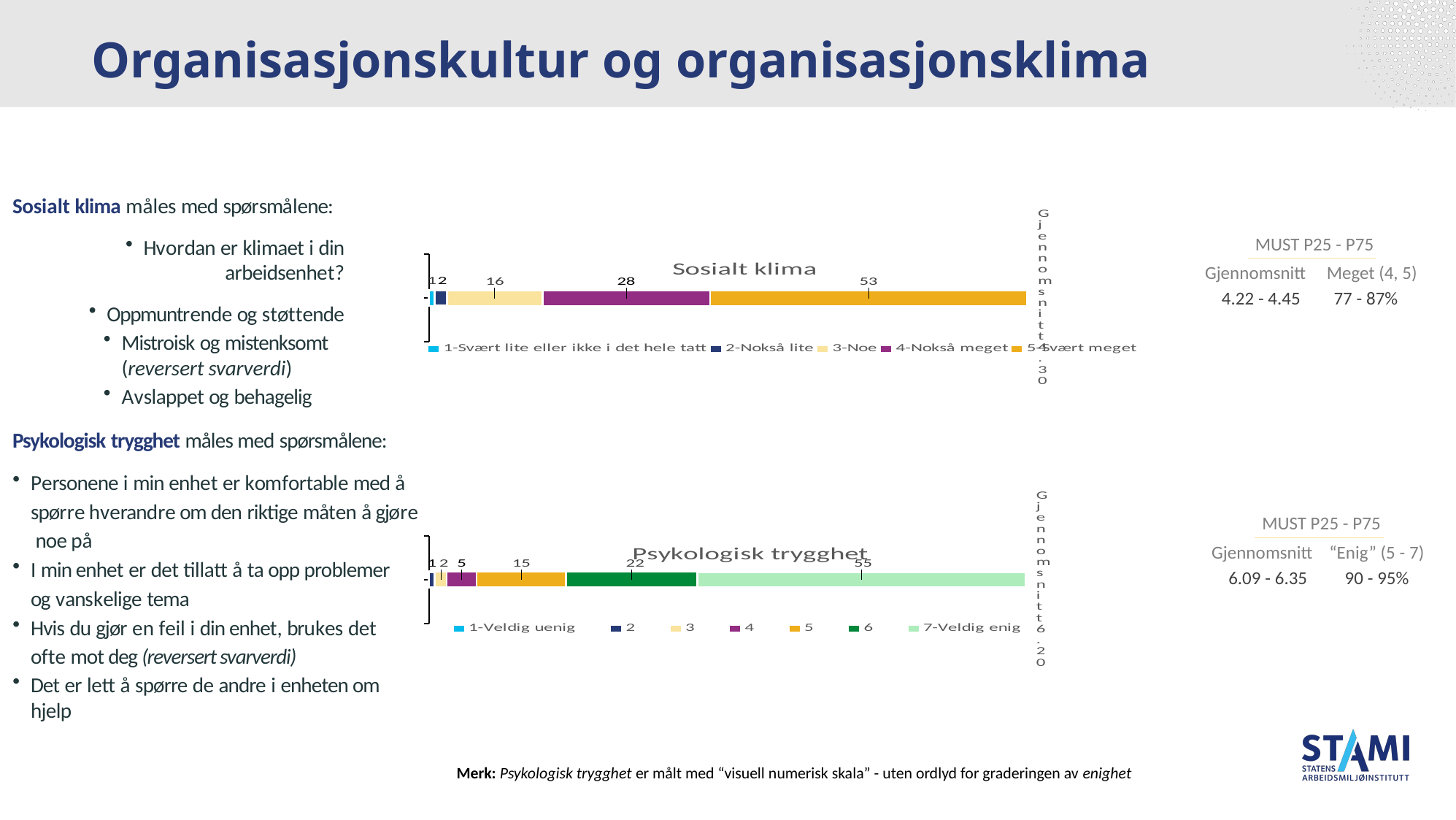
In the Psykologisk trygghet chart, what is the value for 5? 15 In the Sosialt klima chart, what is the value for 3-Noe? 16 In the Sosialt klima chart, which category has the highest value? 5-Svært meget In the Psykologisk trygghet chart, how many series does the legend list? 7 In the Psykologisk trygghet chart, what is the value for 7-Veldig enig? 55 In the Sosialt klima chart, how many series does the legend list? 5 In the Psykologisk trygghet chart, what is the value for 6? 22 In the Sosialt klima chart, what is the value for 5-Svært meget? 53 In the Sosialt klima chart, what is the value for 4-Nokså meget? 28 What kind of chart is the Psykologisk trygghet chart? Stacked bar chart In the Sosialt klima chart, what is the difference between the values for 5-Svært meget and 4-Nokså meget? 25 In the Psykologisk trygghet chart, which is larger, the value for 6 or the value for 5? 6